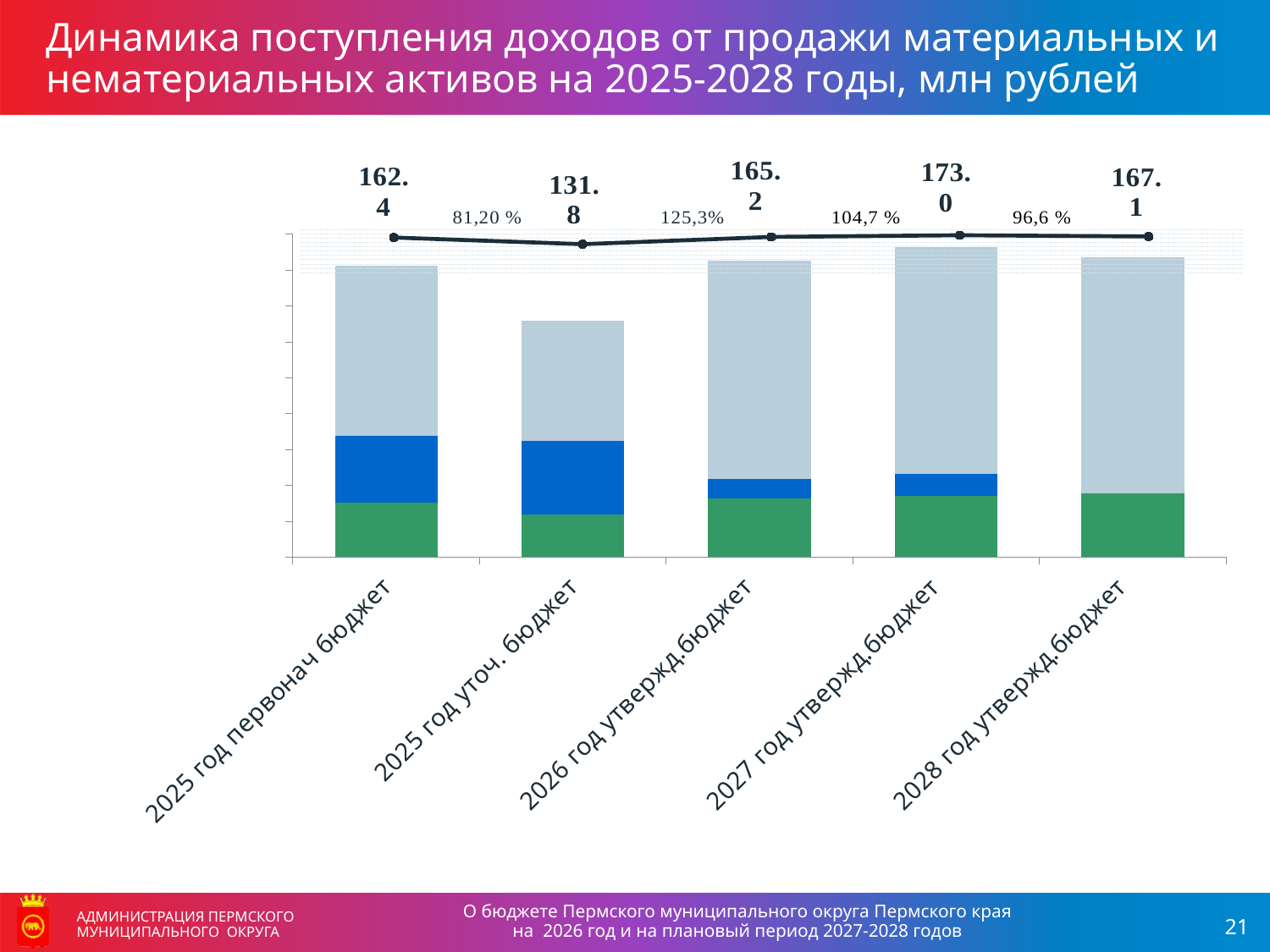
What is the difference between the totals for 2027 год утвержд.бюджет and 2028 год утвержд.бюджет? 5.9 What is the total value shown for 2028 год утвержд.бюджет? 167.1 What is the difference between the totals for 2026 год утвержд.бюджет and 2025 год уточ. бюджет? 33.4 Which has the larger total: 2026 год утвержд.бюджет or 2028 год утвержд.бюджет? 2028 год утвержд.бюджет What percentage is shown between 2025 год уточ. бюджет and 2026 год утвержд.бюджет? 125,3% Which category has the lowest total value? 2025 год уточ. бюджет What is the total value shown for 2025 год первонач бюджет? 162.4 How many categories are shown on the x axis? 5 Do the totals rise or fall from 2025 год уточ. бюджет to 2027 год утвержд.бюджет? rise Which category has the highest total value? 2027 год утвержд.бюджет What kind of chart is shown on the slide? Stacked bar chart with a line What is the total value shown for 2027 год утвержд.бюджет? 173.0